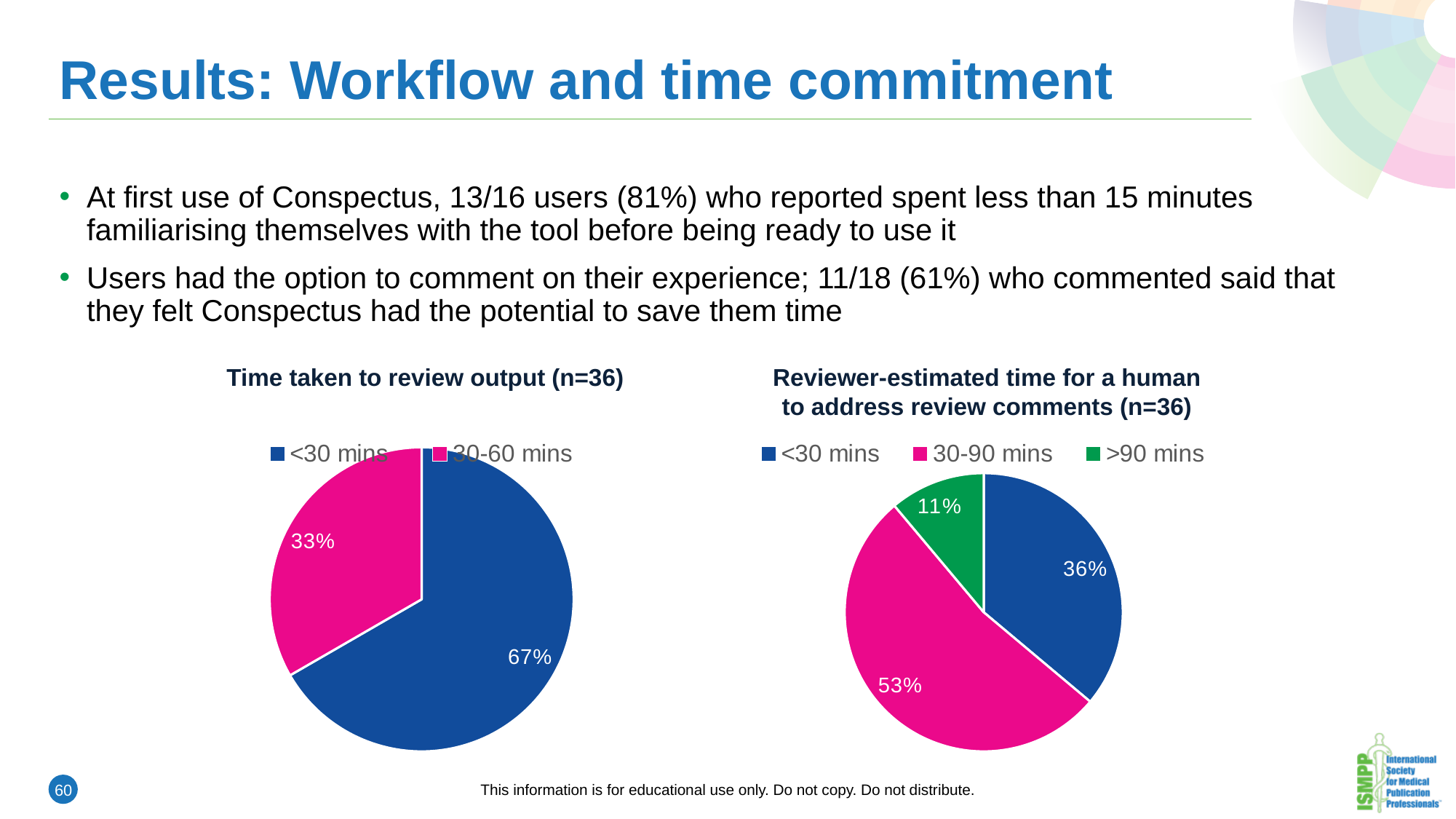
In the 'Time taken to review output (n=36)' chart, which category has the largest slice? <30 mins In the 'Time taken to review output (n=36)' chart, what is the difference in percentage points between the <30 mins and 30-60 mins slices? 34 In the 'Reviewer-estimated time for a human to address review comments (n=36)' chart, what share is >90 mins? 11% In the 'Reviewer-estimated time for a human to address review comments (n=36)' chart, what share is 30-90 mins? 53% In the 'Time taken to review output (n=36)' chart, what share of reviewers took 30-60 mins? 33% In the 'Reviewer-estimated time for a human to address review comments (n=36)' chart, how many categories does the legend list? 3 What type of chart is 'Time taken to review output (n=36)'? Pie chart In the 'Reviewer-estimated time for a human to address review comments (n=36)' chart, which category has the smallest slice? >90 mins In the 'Time taken to review output (n=36)' chart, what share of reviewers took <30 mins? 67% In the 'Time taken to review output (n=36)' chart, how many categories does the legend list? 2 In the 'Reviewer-estimated time for a human to address review comments (n=36)' chart, what share is <30 mins? 36% In the 'Reviewer-estimated time for a human to address review comments (n=36)' chart, which is larger: <30 mins or 30-90 mins? 30-90 mins